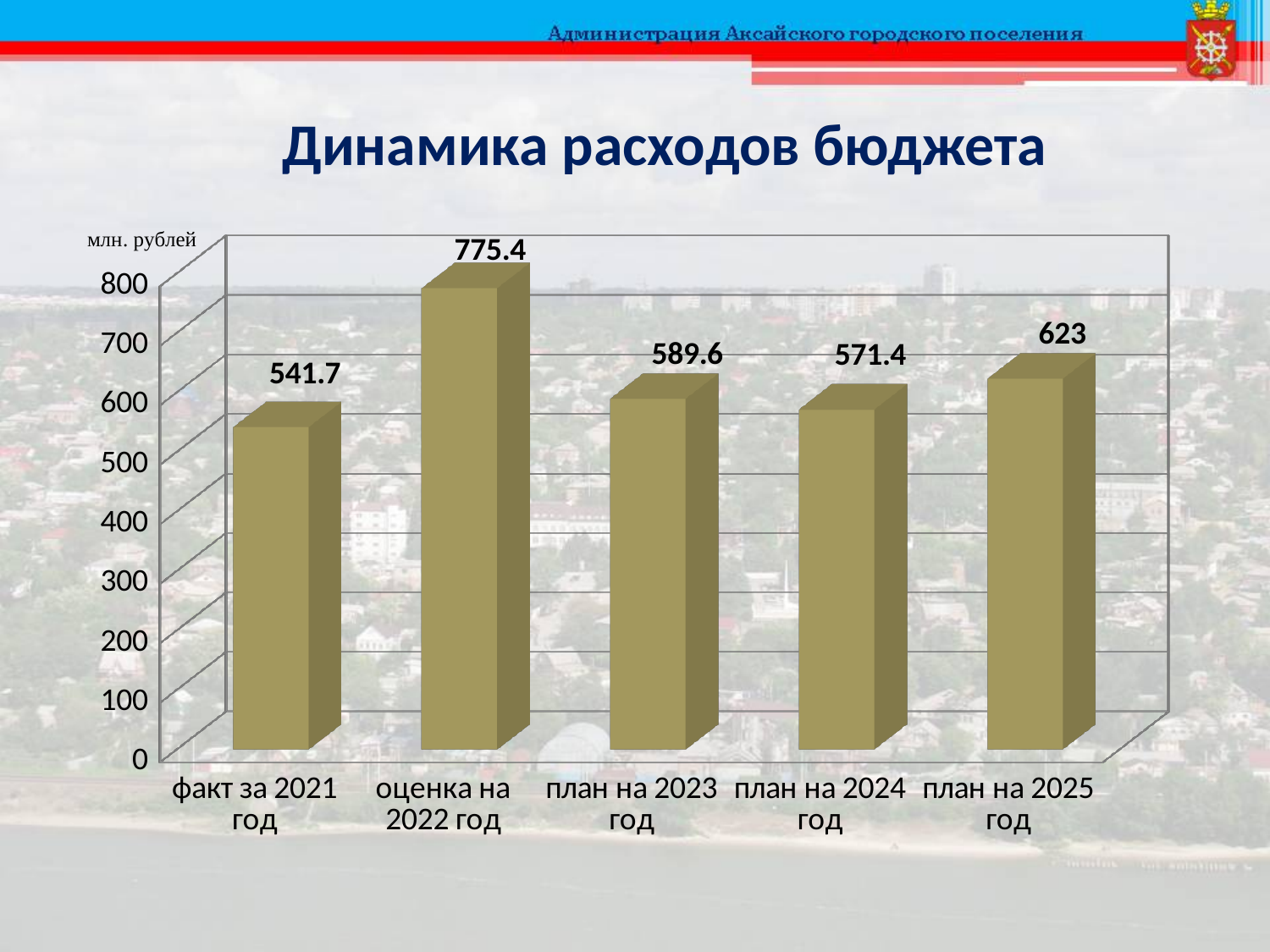
Which is larger, the value for "план на 2023 год" or "план на 2024 год"? план на 2023 год How many categories are shown on the x axis? 5 What is the value for "факт за 2021 год"? 541.7 Which category has the lowest value? факт за 2021 год What is the difference between the values for "оценка на 2022 год" and "план на 2023 год"? 185.8 What is the value for "план на 2025 год"? 623 What is the title of the chart? Динамика расходов бюджета What is the value for "оценка на 2022 год"? 775.4 What is the difference between the values for "план на 2025 год" and "план на 2024 год"? 51.6 Is the value for "план на 2024 год" greater or less than 600? less What kind of chart is shown on the slide? bar chart Which category has the highest value? оценка на 2022 год